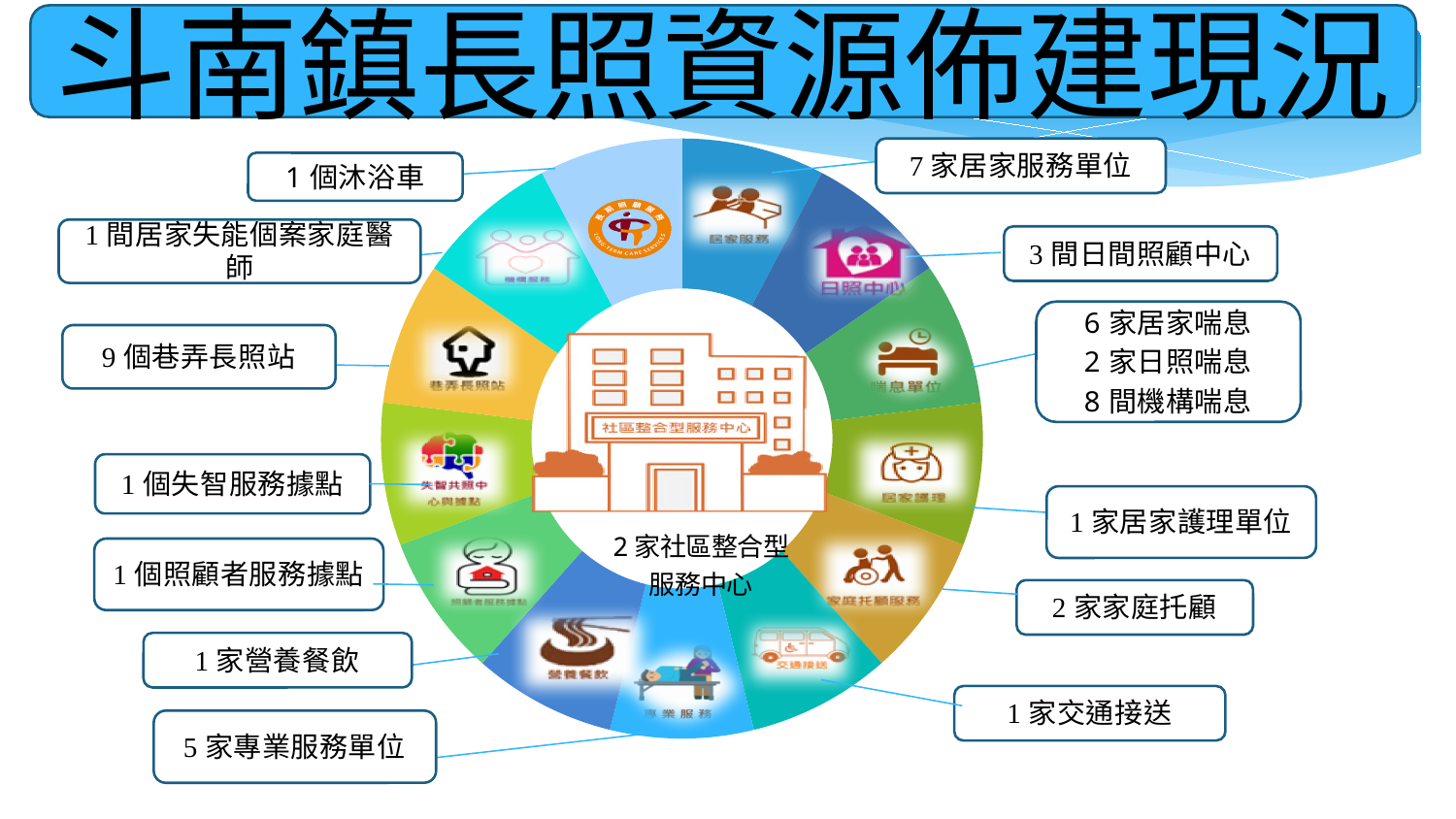
How many 社區整合型服務中心 are shown in the centre of the ring? 2 家 Which resource type has the largest number on the slide? 巷弄長照站 (9 個) How many 家庭托顧 are listed? 2 家 How many 巷弄長照站 does the slide report for 斗南鎮? 9 個 How many 居家服務單位 are shown on the slide? 7 家 What is the title of the slide? 斗南鎮長照資源佈建現況 What is the difference between the number of 機構喘息 (8) and 居家喘息 (6)? 2 How many 日間照顧中心 are listed? 3 間 Which is larger: the number of 居家服務單位 or the number of 專業服務單位? 居家服務單位 How many 機構喘息 are listed in the 喘息 callout? 8 間 What is the difference between the number of 居家服務單位 (7) and 專業服務單位 (5)? 2 How many 專業服務單位 are shown? 5 家